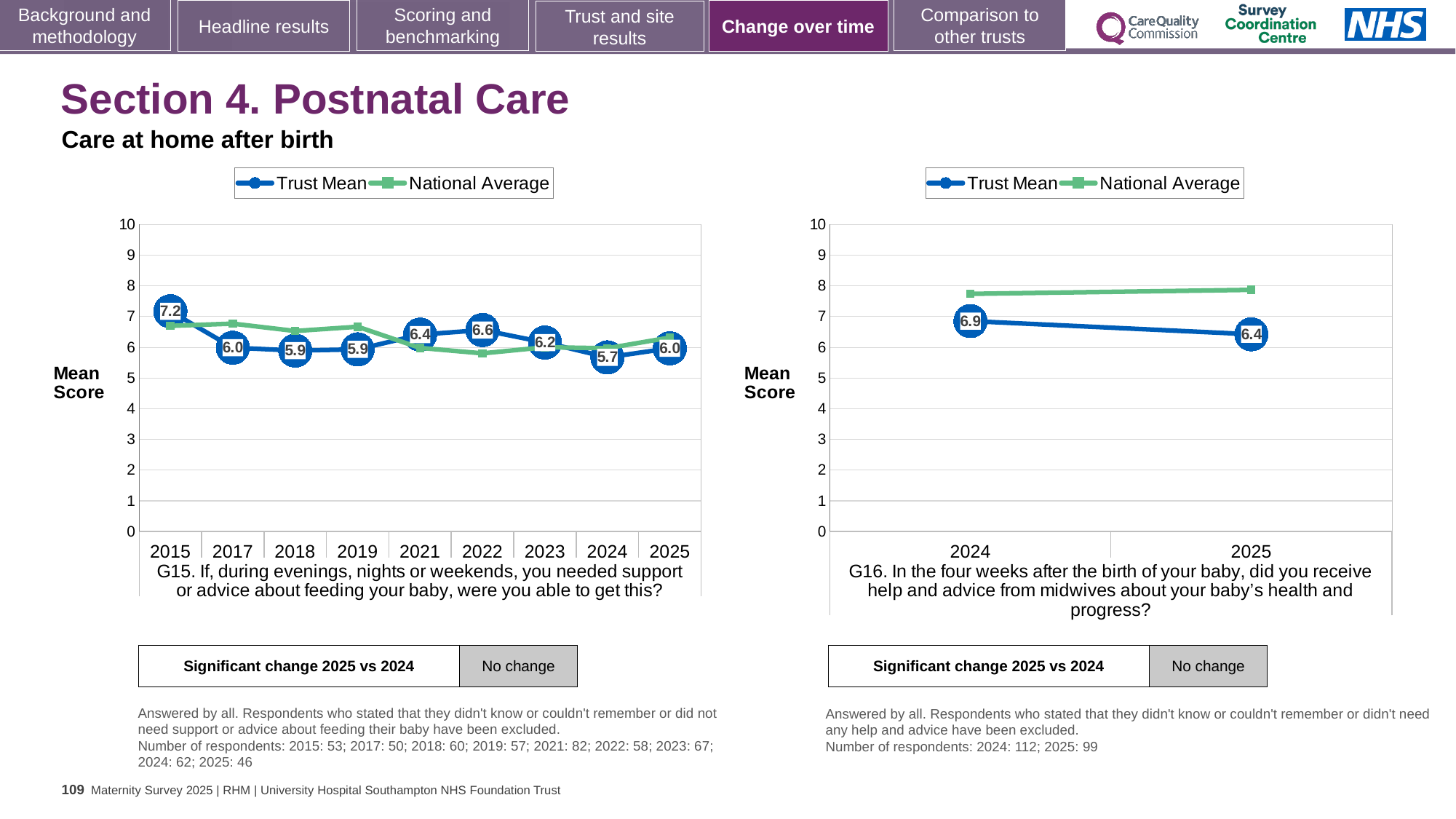
In the G16 chart on the right, is the National Average for 2025 greater or less than 7? greater In the G15 chart on the left, what is the Trust Mean score for 2015? 7.2 In the G16 chart on the right, what is the Trust Mean score for 2025? 6.4 In the G15 chart on the left, what is the Trust Mean score for 2024? 5.7 In the G15 chart on the left, which year has the highest Trust Mean score? 2015 How many series does the legend of the G16 chart on the right list? 2 In the G15 chart on the left, is the National Average for 2015 greater or less than 6? greater In the G16 chart on the right, what is the Trust Mean score for 2024? 6.9 In the G15 chart on the left, how many years are shown on the x axis? 9 In the G15 chart on the left, which year has the lowest Trust Mean score? 2024 In the G16 chart on the right, what is the difference between the Trust Mean scores for 2024 and 2025? 0.5 In the G15 chart on the left, what is the difference between the Trust Mean scores for 2015 and 2024? 1.5